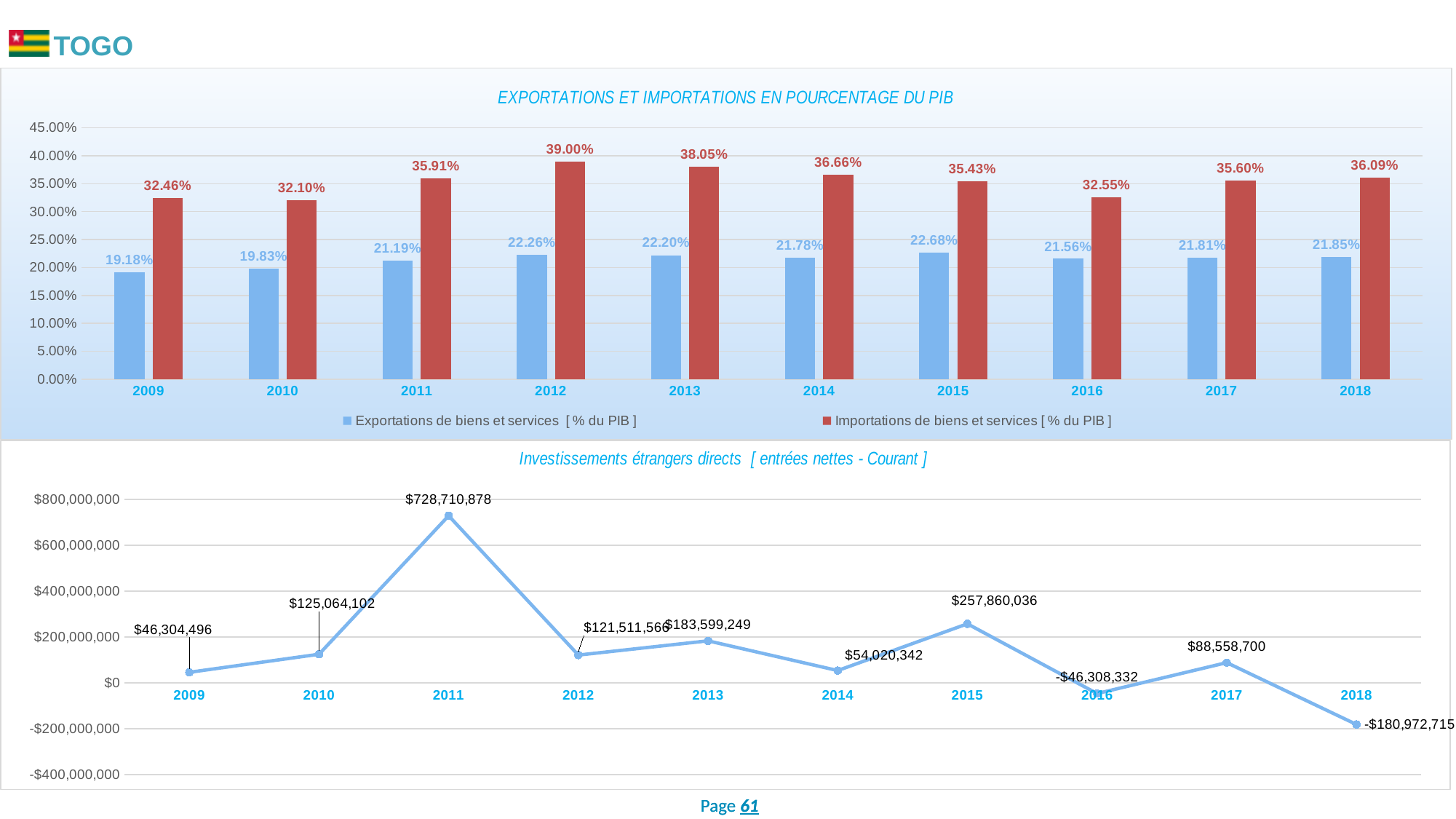
In the chart 'EXPORTATIONS ET IMPORTATIONS EN POURCENTAGE DU PIB', what is the value of Exportations de biens et services in 2012? 22.26% What kind of chart is 'EXPORTATIONS ET IMPORTATIONS EN POURCENTAGE DU PIB'? Bar chart In the chart 'EXPORTATIONS ET IMPORTATIONS EN POURCENTAGE DU PIB', what is the value of Importations de biens et services in 2016? 32.55% In the chart 'Investissements étrangers directs', which is larger, the value for 2013 or the value for 2014? 2013 In the chart 'EXPORTATIONS ET IMPORTATIONS EN POURCENTAGE DU PIB', which year has the lowest value for Exportations de biens et services? 2009 In the chart 'EXPORTATIONS ET IMPORTATIONS EN POURCENTAGE DU PIB', how many series does the legend list? 2 In the chart 'Investissements étrangers directs', what is the value for 2018? -$180,972,715 In the chart 'EXPORTATIONS ET IMPORTATIONS EN POURCENTAGE DU PIB', what is the difference between Importations and Exportations in 2012? 16.74% In the chart 'EXPORTATIONS ET IMPORTATIONS EN POURCENTAGE DU PIB', which year has the highest value for Importations de biens et services? 2012 In the chart 'Investissements étrangers directs', what is the value for 2011? $728,710,878 In the chart 'Investissements étrangers directs', which year has the lowest value? 2018 How many years are plotted in the chart 'Investissements étrangers directs'? 10